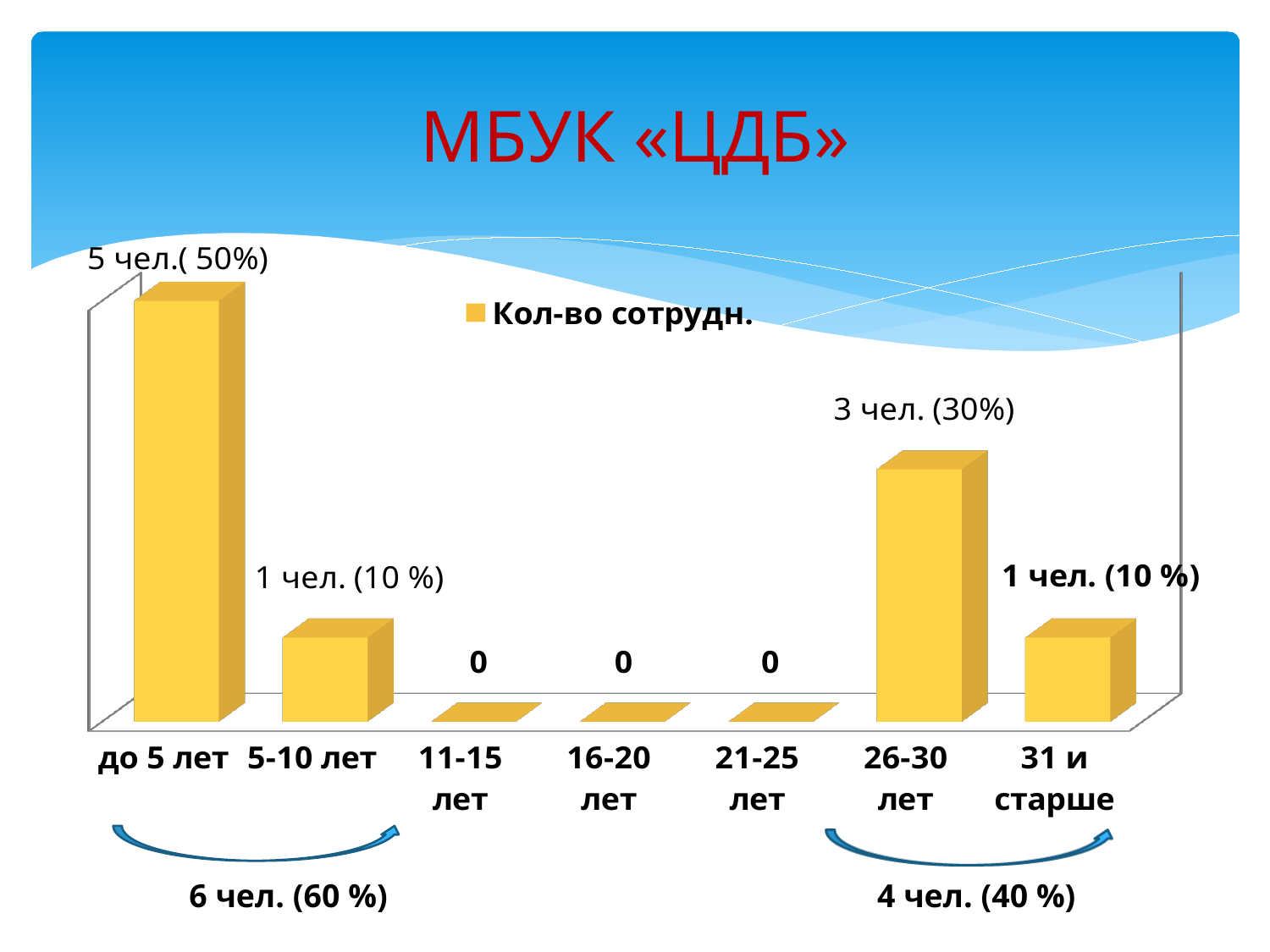
What is the value for the category '11-15 лет'? 0 Which is larger, the value for '26-30 лет' or the value for '31 и старше'? 26-30 лет What is the value for the category '5-10 лет'? 1 чел. (10 %) What is the difference in number of employees between 'до 5 лет' and '26-30 лет'? 2 How many series does the legend list? 1 What is the value for the category 'до 5 лет'? 5 чел.( 50%) What is the legend entry of the series shown? Кол-во сотрудн. What is the value for the category '26-30 лет'? 3 чел. (30%) How many categories have a value of 0? 3 Which category has the highest value? до 5 лет How many categories are shown on the x axis? 7 What type of chart is shown on the slide? bar chart